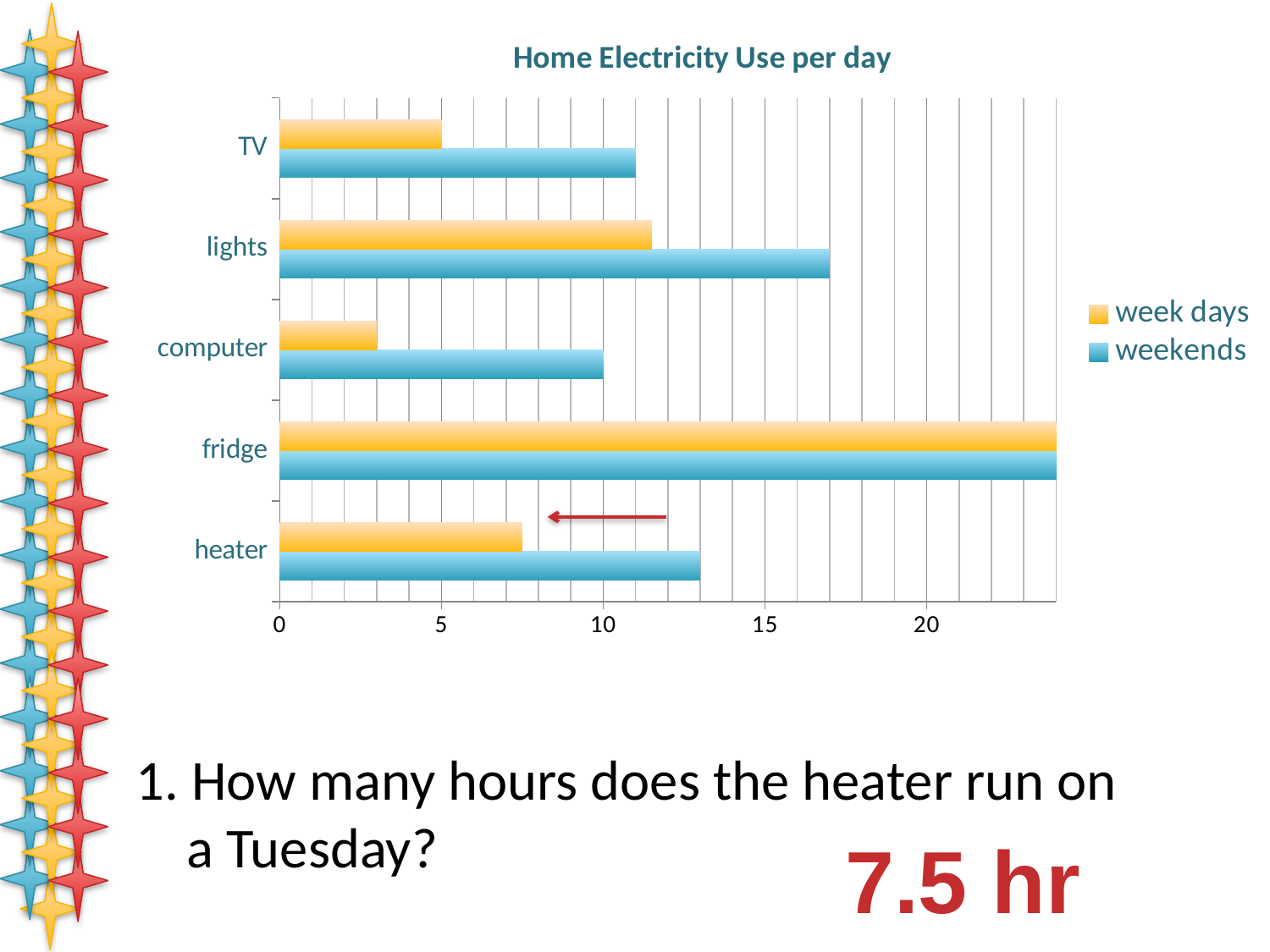
Which category has the lowest week days value? computer Is the weekends value for lights greater or less than 15? greater What is the title of the chart? Home Electricity Use per day What is the weekends value for computer? 10 How many categories are shown on the chart? 5 What kind of chart is shown on the slide? bar chart Which is larger for lights: the week days value or the weekends value? weekends Which category has the highest weekends value? fridge Is the weekends value for heater greater or less than 15? less How many series does the legend list? 2 How many hours does the heater run on a week day? 7.5 hr What is the week days value for TV? 5